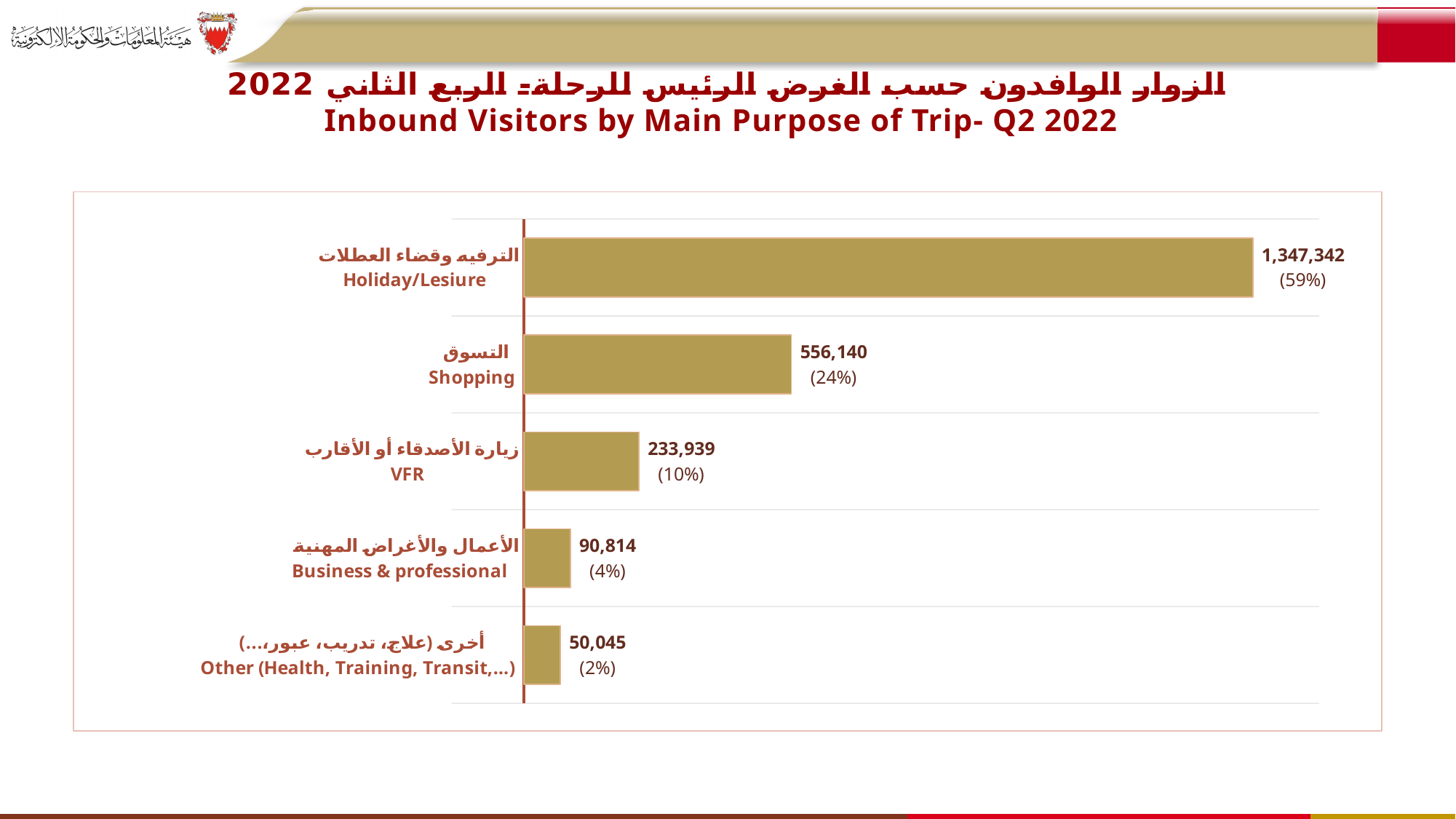
What type of chart is shown on the slide? Bar chart How many purpose-of-trip categories are shown in the chart? 5 What is the number of inbound visitors for Holiday/Lesiure? 1,347,342 What is the number of inbound visitors for Shopping? 556,140 What is the number of inbound visitors for Business & professional? 90,814 What is the number of inbound visitors for VFR? 233,939 Which has more inbound visitors, Shopping or VFR? Shopping Which purpose of trip has the lowest number of inbound visitors? Other (Health, Training, Transit,...) What is the difference between the number of visitors for VFR and Business & professional? 143,125 What is the difference between the number of visitors for Holiday/Lesiure and Shopping? 791,202 What percentage share is shown for Other (Health, Training, Transit,...)? 2% Which purpose of trip has the highest number of inbound visitors? Holiday/Lesiure